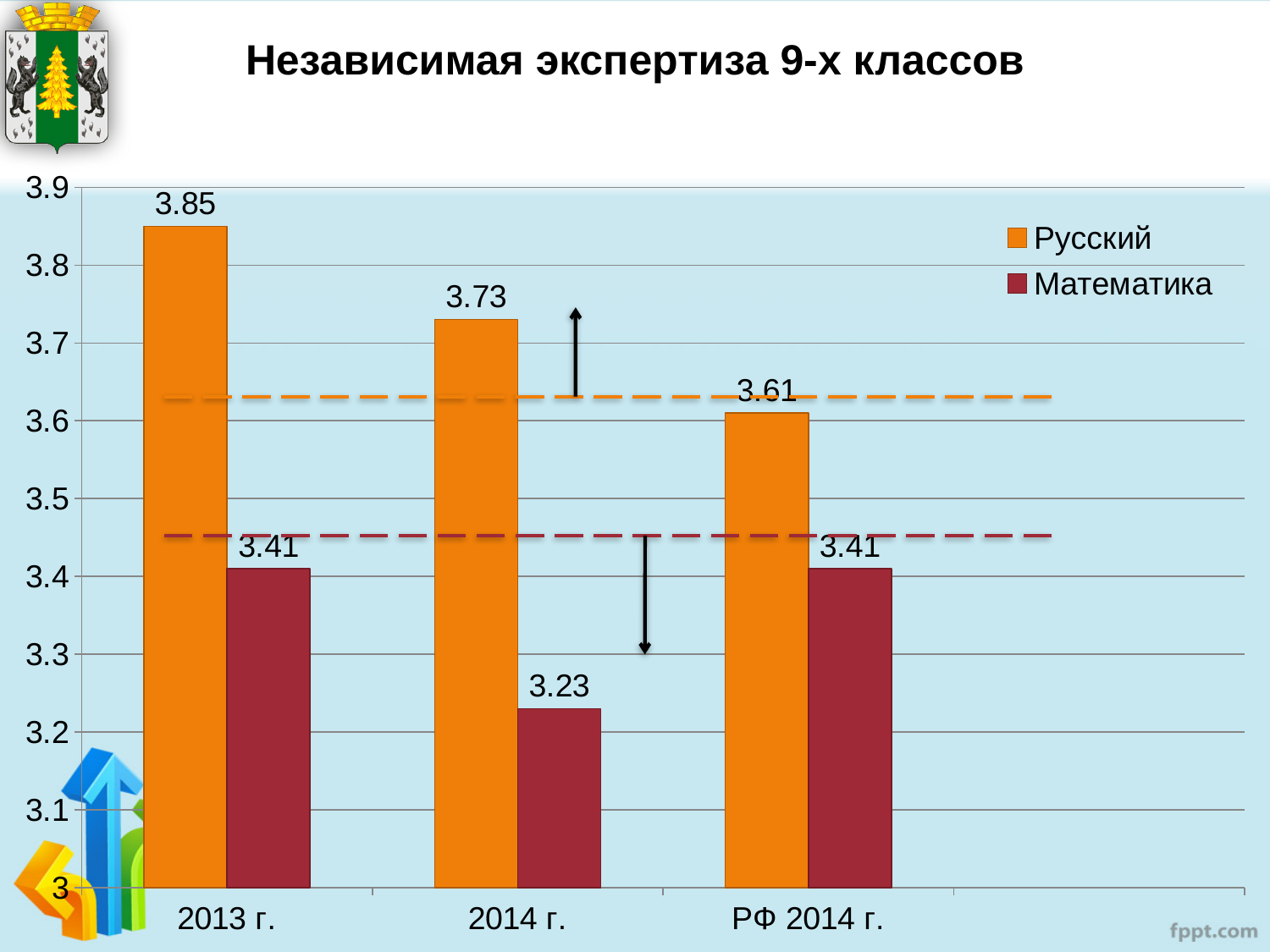
How many series does the legend list? 2 What is the value for Математика in 2014 г.? 3.23 What is the value for Русский for РФ 2014 г.? 3.61 Does the value for Русский rise or fall from 2013 г. to РФ 2014 г.? Fall What is the value for Русский in 2013 г.? 3.85 Which category has the highest value for Русский? 2013 г. What kind of chart is shown on the slide? Bar chart What is the difference between the Русский values for 2013 г. and 2014 г.? 0.12 How many categories are shown on the x axis? 3 Which category has the lowest value for Математика? 2014 г. Which is larger: Математика in 2013 г. or Математика in 2014 г.? 2013 г. What is the value for Математика for РФ 2014 г.? 3.41